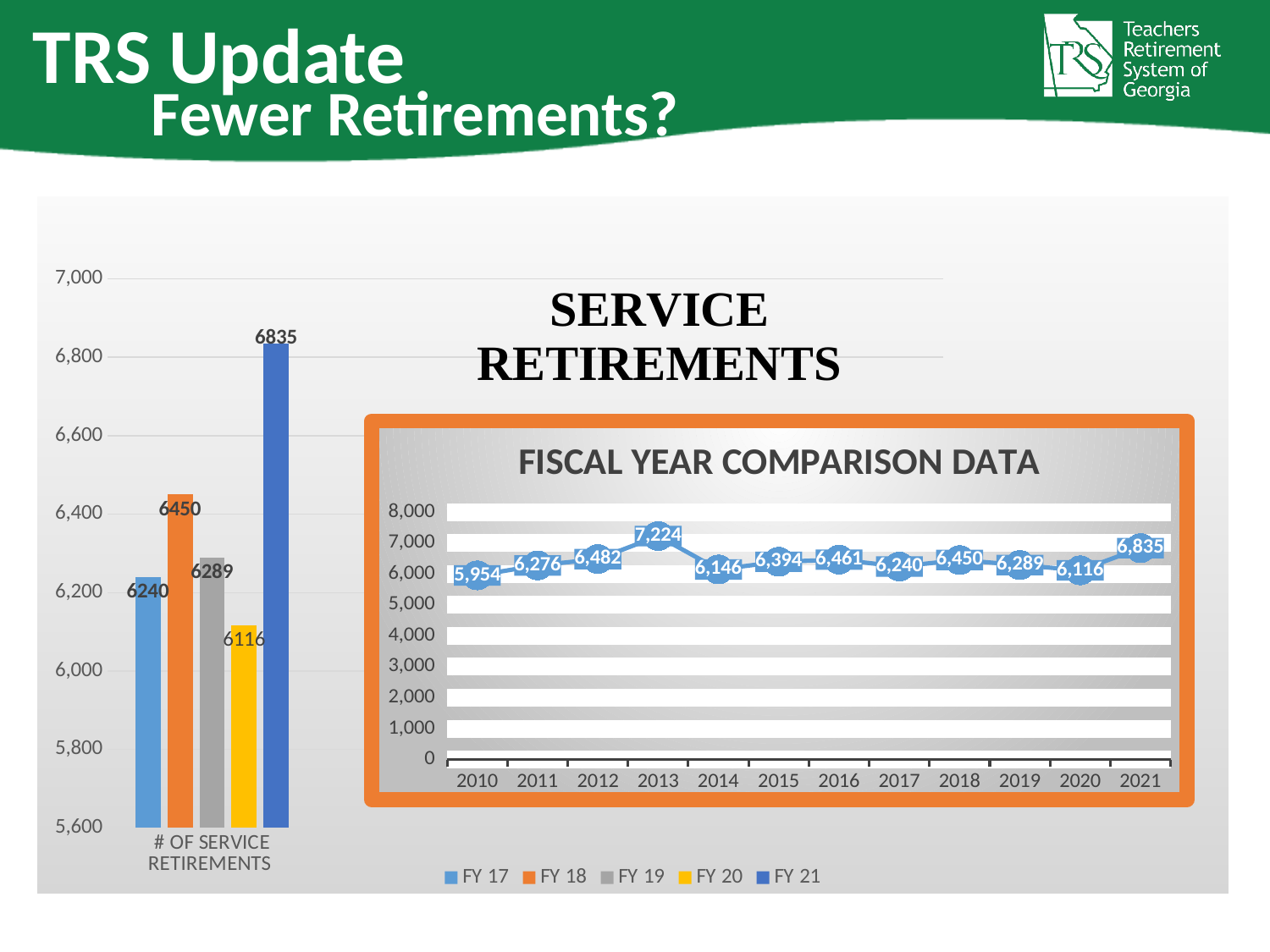
In the bar chart on the left, which fiscal year has the highest number of service retirements? FY 21 In the Fiscal Year Comparison Data chart, which year has the highest value? 2013 In the Fiscal Year Comparison Data chart, what is the value for 2013? 7,224 In the bar chart on the left, which fiscal year has the lowest number of service retirements? FY 20 In the Fiscal Year Comparison Data chart, what is the value for 2010? 5,954 What kind of chart is the Fiscal Year Comparison Data chart? Line chart How many years are plotted in the Fiscal Year Comparison Data chart? 12 In the bar chart on the left, what is the difference between the FY 18 and FY 17 values? 210 In the bar chart on the left, what is the value for FY 20? 6116 In the bar chart on the left, what is the value for FY 21? 6835 In the Fiscal Year Comparison Data chart, which year has the lowest value? 2010 How many series does the legend of the bar chart on the left list? 5